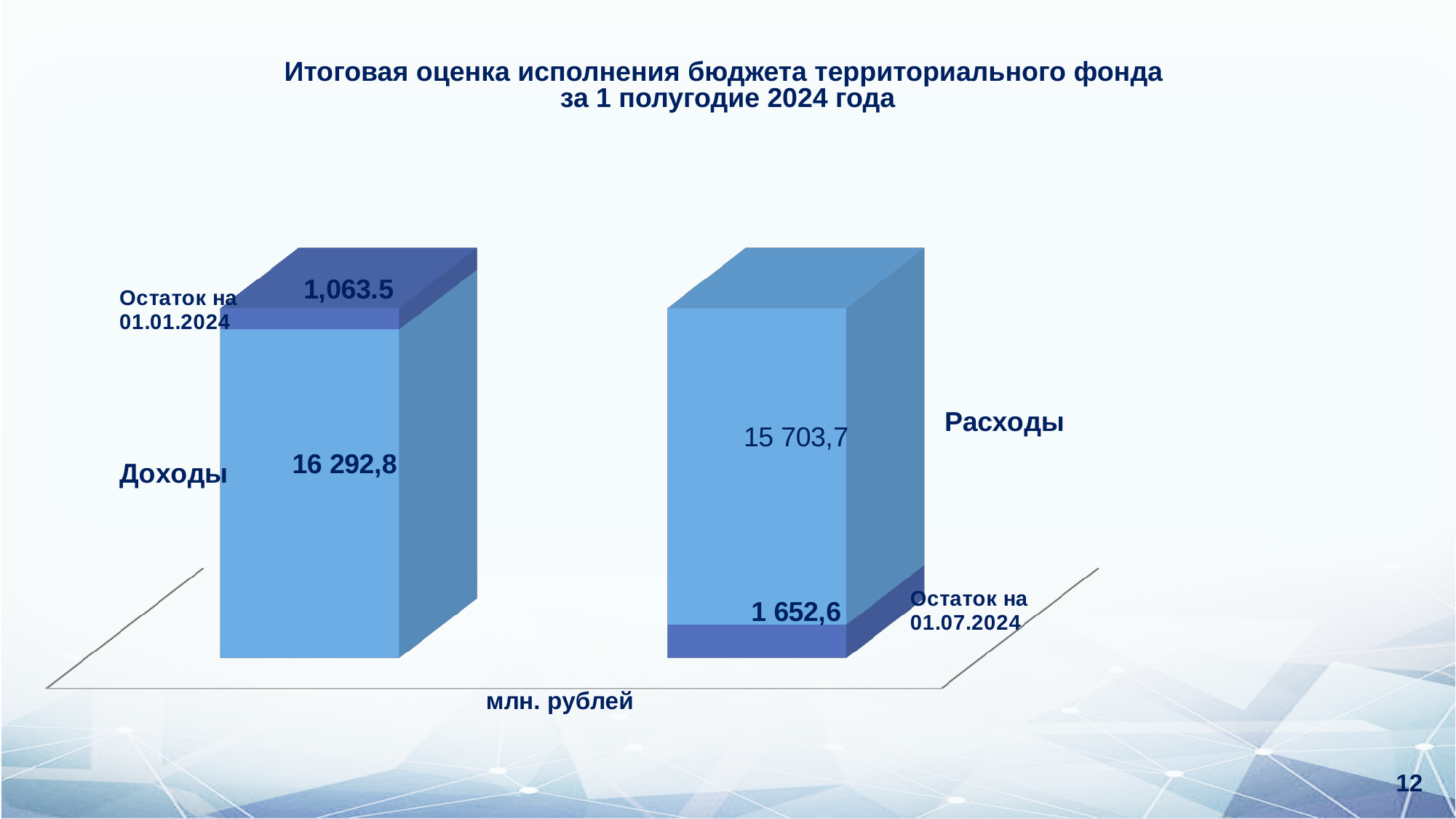
Which is larger, the остаток на 01.01.2024 or the остаток на 01.07.2024? Остаток на 01.07.2024 What is the total of the Расходы bar including the остаток на 01.07.2024 segment? 17 356,3 How many bars are shown in the chart? 2 Which is larger, the Доходы value of 16 292,8 or the Расходы value of 15 703,7? Доходы What is the value of the Доходы bar (excluding the остаток segment)? 16 292,8 What is the value labelled 'Остаток на 01.07.2024'? 1 652,6 What type of chart is shown on the slide? Bar chart What is the difference between the остаток на 01.07.2024 (1 652,6) and the остаток на 01.01.2024 (1,063.5)? 589,1 What is the value of the Расходы bar (excluding the остаток segment)? 15 703,7 What is the value labelled 'Остаток на 01.01.2024'? 1,063.5 In what units are the values on the chart expressed? млн. рублей What is the difference between the Доходы value (16 292,8) and the Расходы value (15 703,7)? 589,1